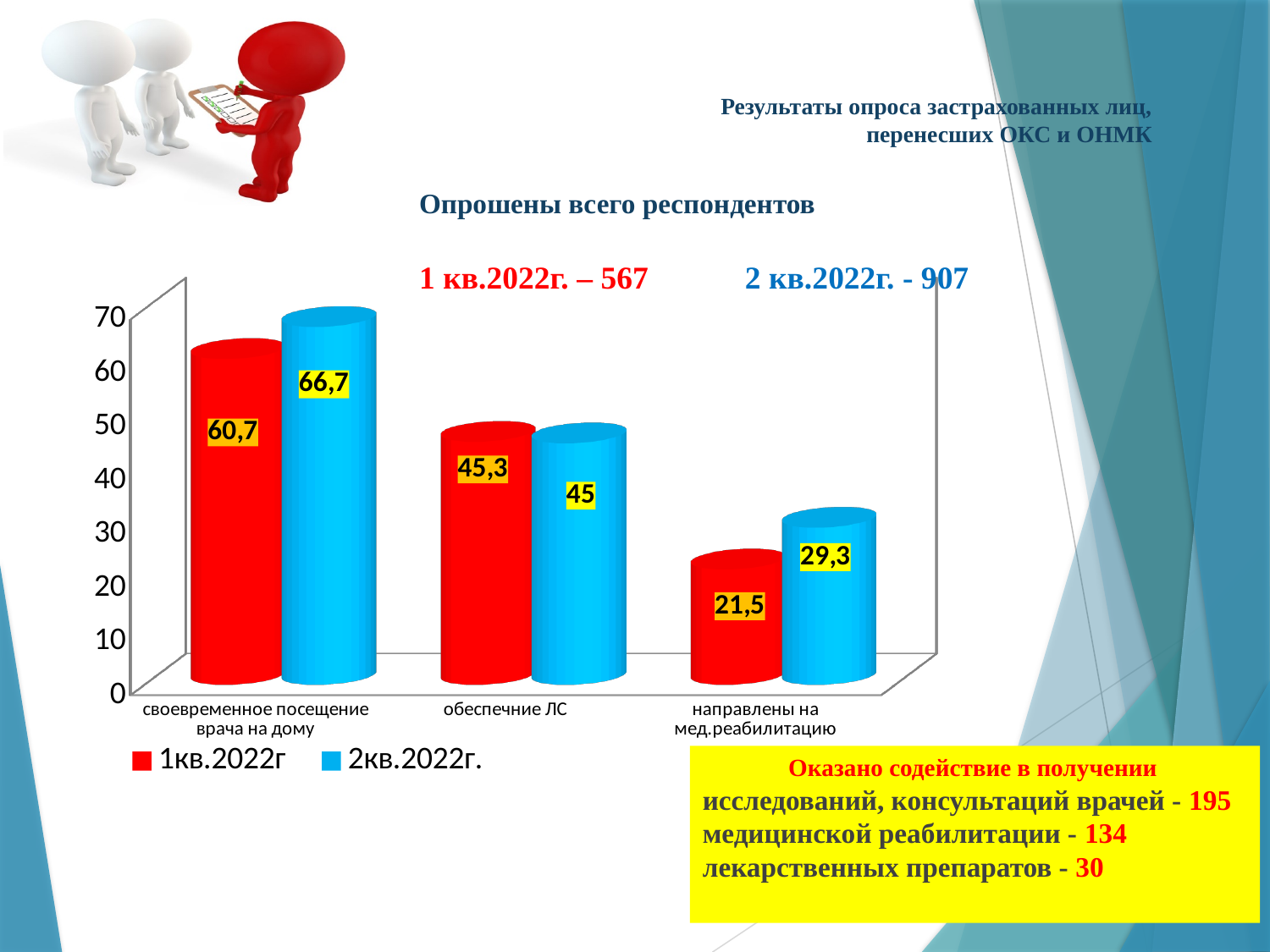
Which series has the larger value for "направлены на мед.реабилитацию", 1кв.2022г or 2кв.2022г.? 2кв.2022г. What is the value for 1кв.2022г in the category "своевременное посещение врача на дому"? 60,7 How many categories are shown on the x axis of the chart? 3 What is the difference between the 2кв.2022г. and 1кв.2022г values for "направлены на мед.реабилитацию"? 7,8 What kind of chart is shown on the slide? bar chart Which category has the highest value for 2кв.2022г.? своевременное посещение врача на дому What is the value for 2кв.2022г. in the category "направлены на мед.реабилитацию"? 29,3 Which category has the lowest value for 1кв.2022г? направлены на мед.реабилитацию Which colour represents the series 1кв.2022г in the chart? red What is the difference between the 2кв.2022г. and 1кв.2022г values for "своевременное посещение врача на дому"? 6 How many series does the chart legend list? 2 What is the value for 2кв.2022г. in the category "обеспечние ЛС"? 45